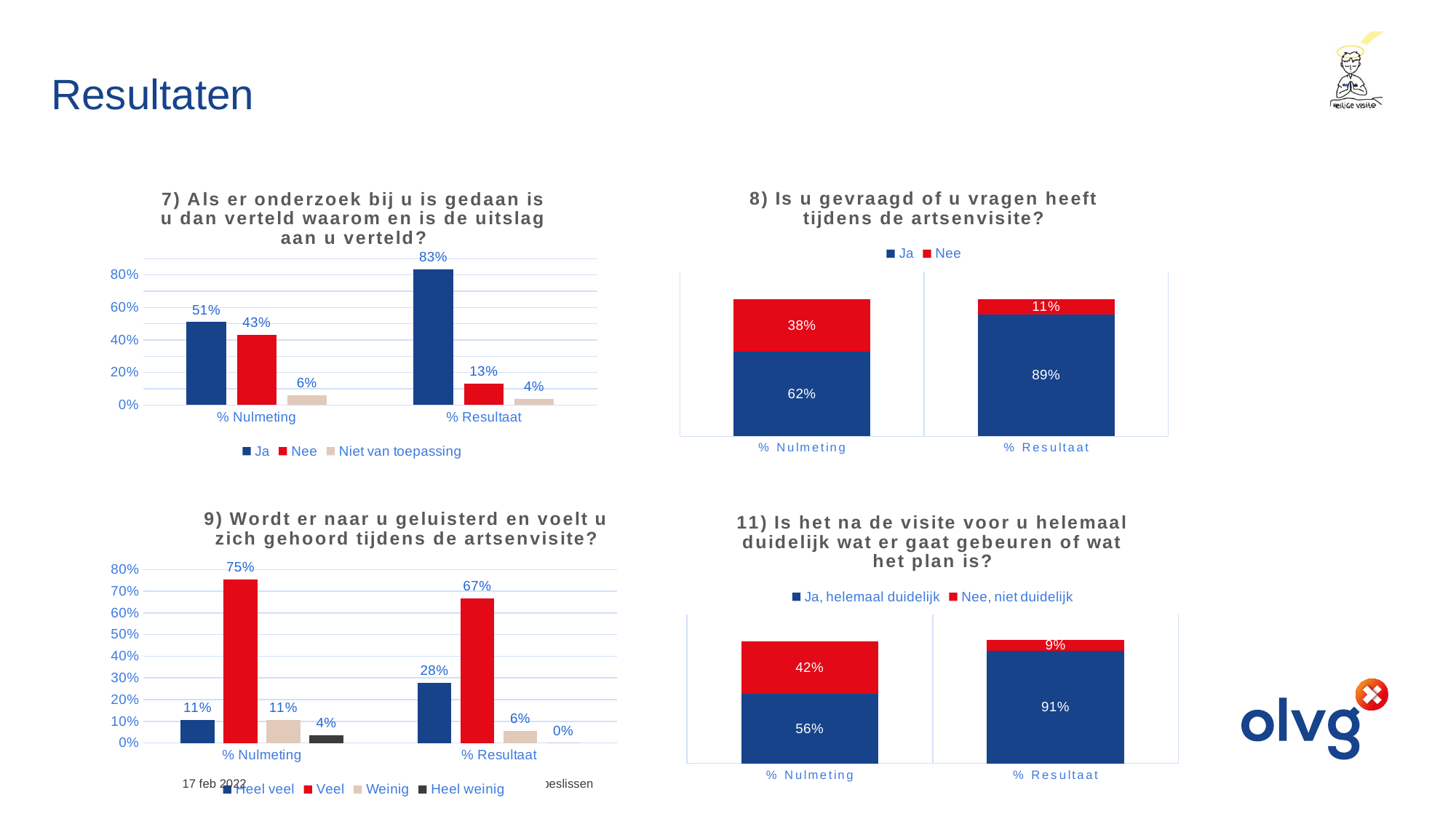
In the bottom-left chart (question 9), what is the value for Heel veel in % Resultaat? 28% In the chart titled "7) Als er onderzoek bij u is gedaan..." (top left), what is the value for Ja in % Resultaat? 83% In the bottom-right chart (question 11), what is the value for "Ja, helemaal duidelijk" in % Resultaat? 91% In the bottom-right chart (question 11), what is the difference between the "Nee, niet duidelijk" values for % Nulmeting and % Resultaat? 33% In the top-left chart (question 7), what is the difference between the Ja values for % Resultaat and % Nulmeting? 32% In the top-right chart (question 8), what is the total of the stacked bar for % Resultaat? 100% In the bottom-left chart (question 9), which category has the highest value in % Nulmeting? Veel In the top-left chart (question 7), what is the value for Nee in % Nulmeting? 43% In the top-right chart (question 8), what is the value for Nee in % Nulmeting? 38% How many series does the legend of the top-left chart (question 7) list? 3 What kind of chart is the top-right chart (question 8)? Stacked bar chart In the bottom-left chart (question 9), which is larger: Weinig in % Nulmeting or Weinig in % Resultaat? Weinig in % Nulmeting